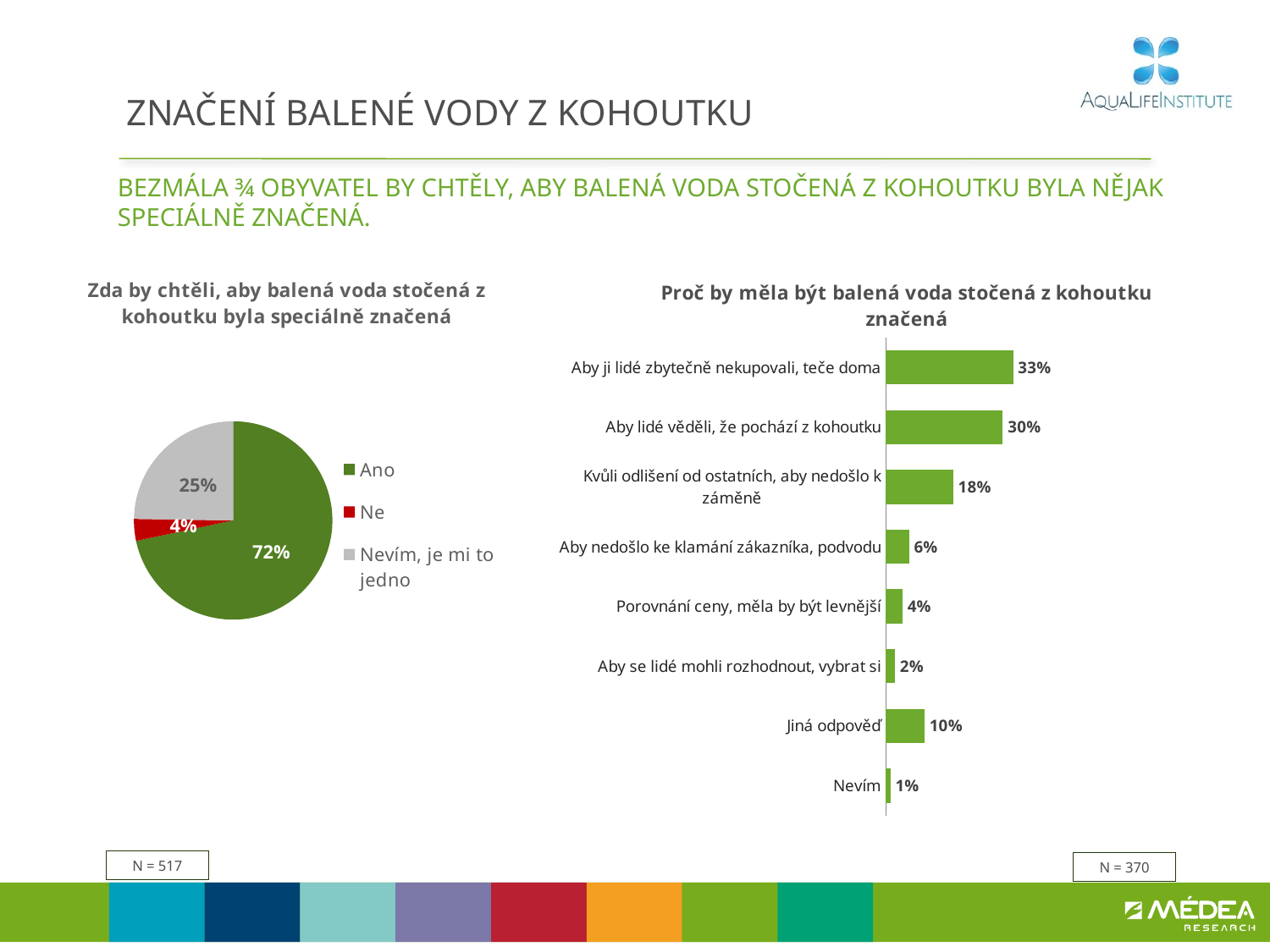
In the bar chart on the right, what is the difference between "Aby ji lidé zbytečně nekupovali, teče doma" and "Kvůli odlišení od ostatních, aby nedošlo k záměně"? 15% In the bar chart on the right, what is the value for "Aby lidé věděli, že pochází z kohoutku"? 30% In the pie chart on the left, what share of respondents answered "Ano"? 72% In the pie chart on the left, what share of respondents answered "Ne"? 4% In the bar chart on the right, which category has the highest value? Aby ji lidé zbytečně nekupovali, teče doma In the bar chart on the right, which is larger: "Jiná odpověď" or "Aby nedošlo ke klamání zákazníka, podvodu"? Jiná odpověď In the pie chart on the left, how many entries does the legend list? 3 What type of chart is the chart on the right, "Proč by měla být balená voda stočená z kohoutku značená"? bar chart In the bar chart on the right, which category has the lowest value? Nevím How many categories are shown in the bar chart on the right? 8 In the pie chart on the left, what share of respondents answered "Nevím, je mi to jedno"? 25% In the pie chart on the left, which answer has the smallest share? Ne